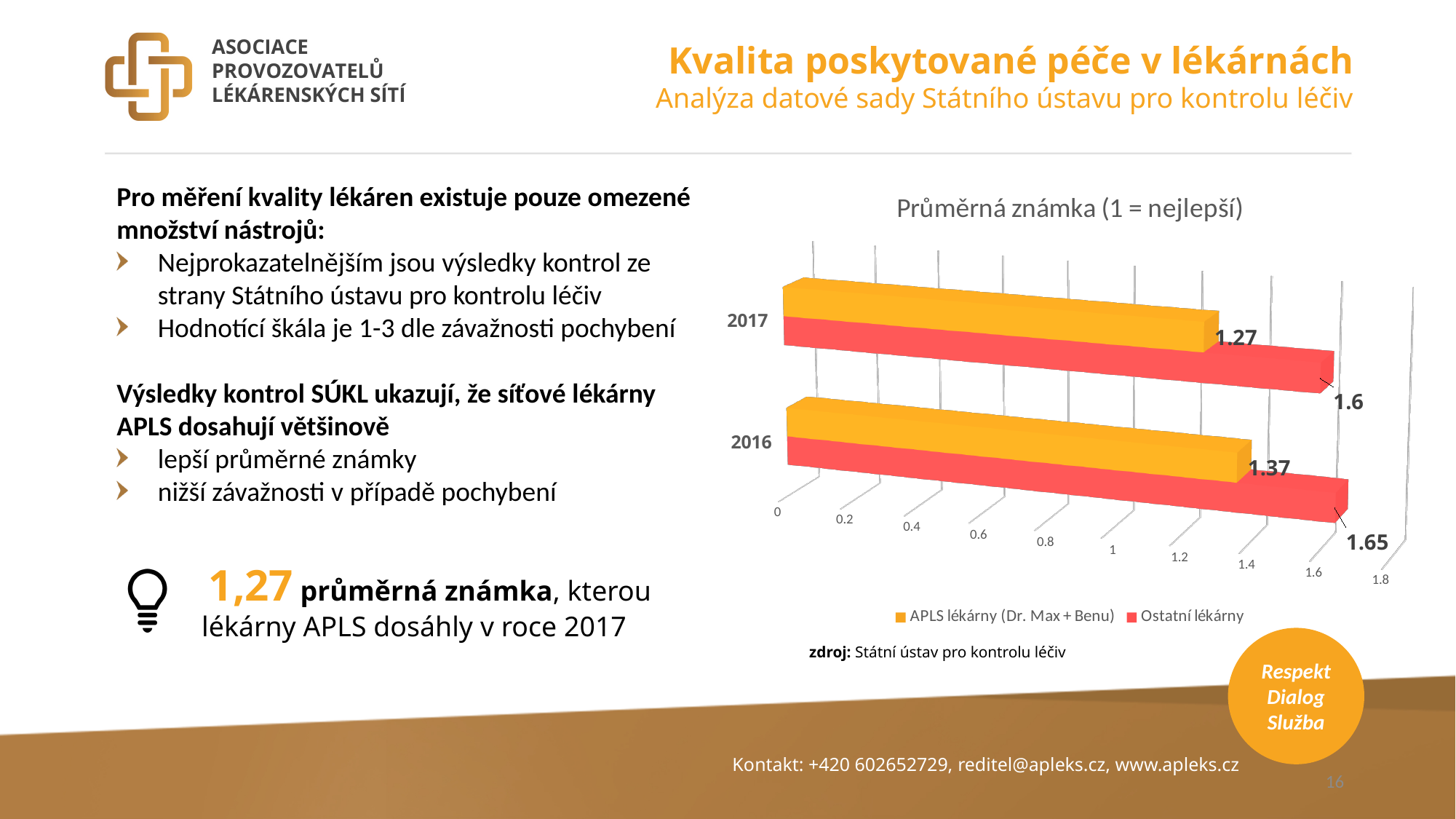
What is the title of the chart? Průměrná známka (1 = nejlepší) Which colour represents Ostatní lékárny in the chart? red What is the value for APLS lékárny (Dr. Max + Benu) in 2017? 1.27 How many series does the chart legend list? 2 What is the value for Ostatní lékárny in 2016? 1.65 Which year has the lowest value for APLS lékárny (Dr. Max + Benu)? 2017 What is the value for APLS lékárny (Dr. Max + Benu) in 2016? 1.37 What type of chart is shown on the slide? bar chart Which series has the higher value in 2016, APLS lékárny (Dr. Max + Benu) or Ostatní lékárny? Ostatní lékárny How many years (categories) are shown on the chart? 2 What is the difference between Ostatní lékárny and APLS lékárny (Dr. Max + Benu) in 2017? 0.33 What is the value for Ostatní lékárny in 2017? 1.6